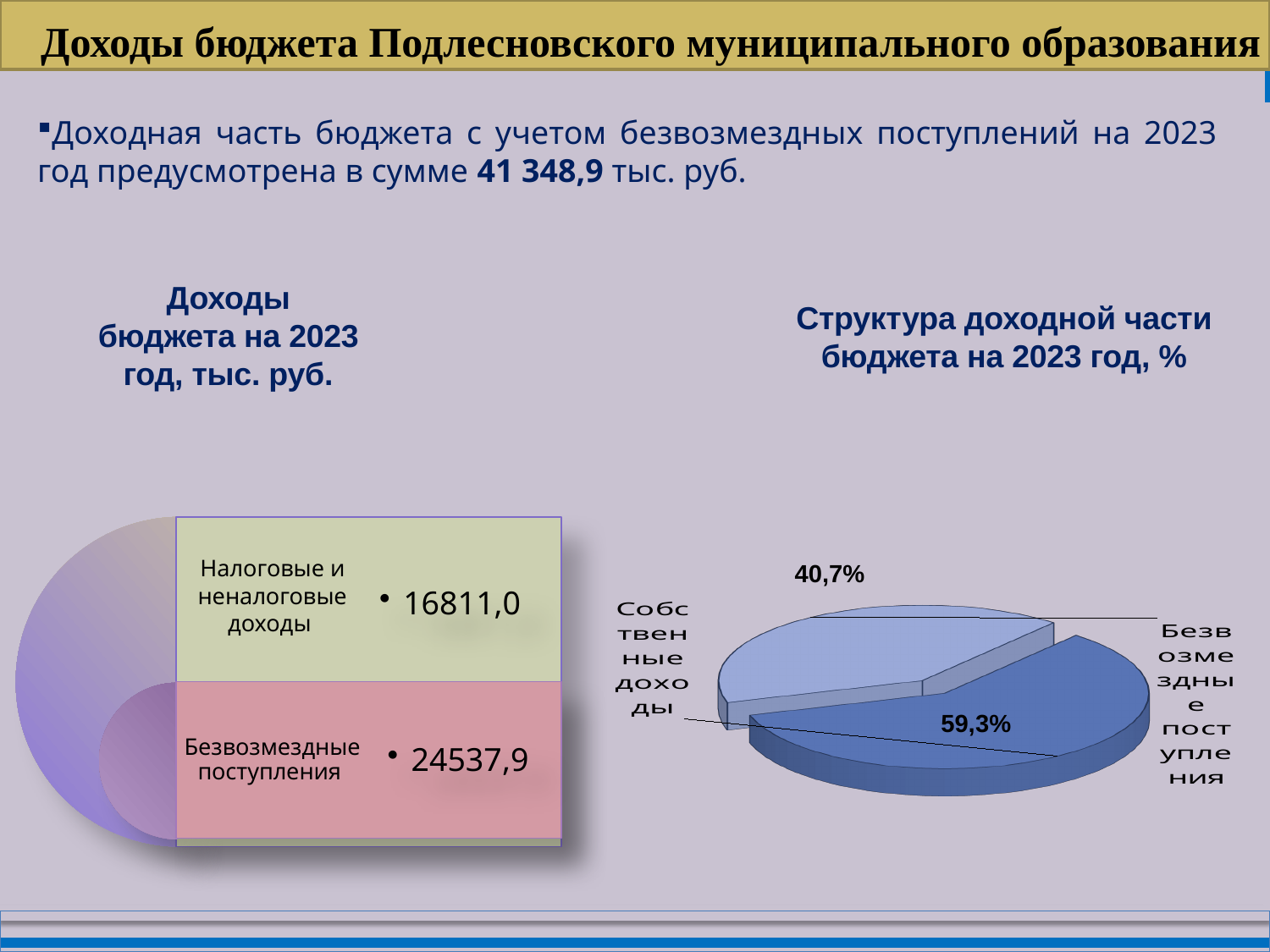
What is the title of the pie chart on the right side of the slide? Структура доходной части бюджета на 2023 год, % In the pie chart "Структура доходной части бюджета на 2023 год, %", what share is shown for Собственные доходы? 40,7% In the pie chart "Структура доходной части бюджета на 2023 год, %", which slice is the smallest? Собственные доходы In the pie chart "Структура доходной части бюджета на 2023 год, %", which is larger: Собственные доходы or Безвозмездные поступления? Безвозмездные поступления In the pie chart "Структура доходной части бюджета на 2023 год, %", how many slices are there? 2 In the pie chart "Структура доходной части бюджета на 2023 год, %", is the share for Собственные доходы greater or less than 50%? less In the pie chart "Структура доходной части бюджета на 2023 год, %", which slice is drawn in the darker blue colour? Безвозмездные поступления In the pie chart "Структура доходной части бюджета на 2023 год, %", what share is shown for Безвозмездные поступления? 59,3% In the pie chart "Структура доходной части бюджета на 2023 год, %", what is the difference in percentage points between Безвозмездные поступления and Собственные доходы? 18,6 In the pie chart "Структура доходной части бюджета на 2023 год, %", which slice is the largest? Безвозмездные поступления What kind of chart is the chart titled "Структура доходной части бюджета на 2023 год, %"? pie chart